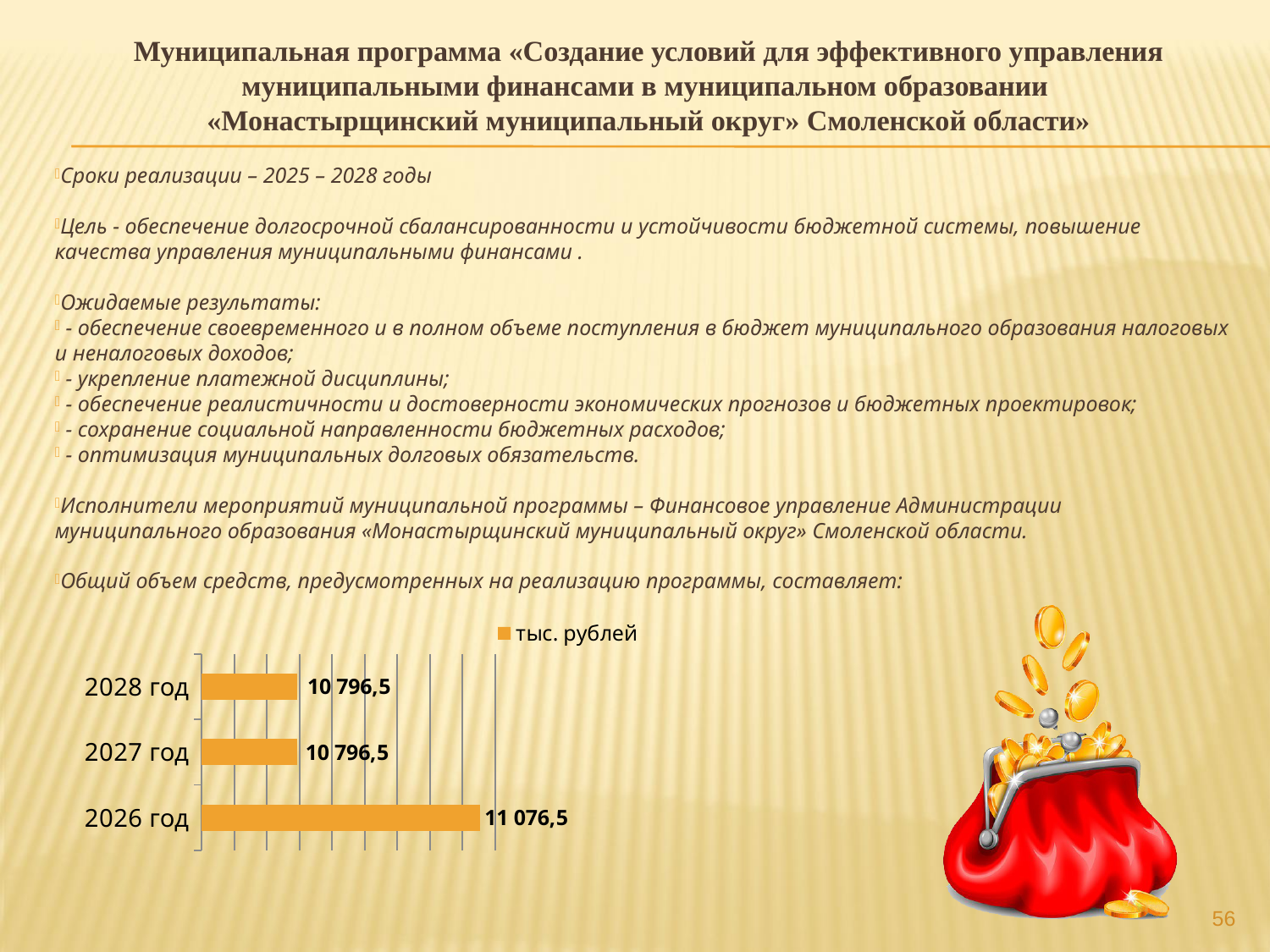
What colour are the bars in the chart? Orange What is the value for 2026 год? 11 076,5 What is the value for 2027 год? 10 796,5 Which year has the highest value? 2026 год How many years are shown in the chart? 3 What is the difference between the values for 2026 год and 2027 год? 280 What is the value for 2028 год? 10 796,5 How many series does the legend list? 1 Are the values for 2027 год and 2028 год equal? Yes Which is larger, the value for 2026 год or the value for 2028 год? 2026 год What kind of chart is shown on the slide? Bar chart What is the legend entry of the chart? тыс. рублей